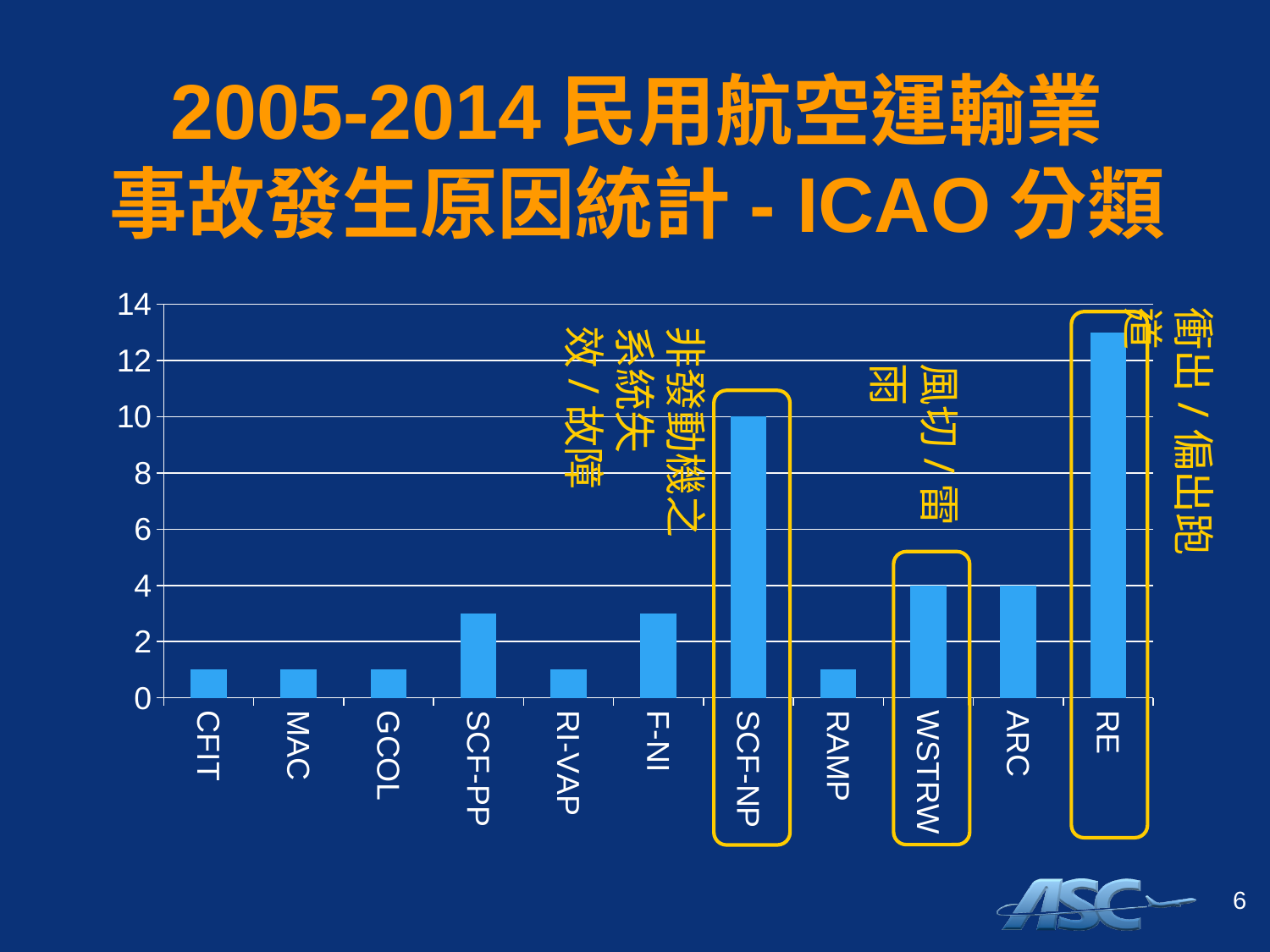
Is the value for SCF-PP greater or less than 4? less What is the value for ARC? 4 How many bars are outlined with yellow boxes in the chart? 3 Is the value for CFIT greater or less than 2? less What is the value for SCF-NP? 10 What is the difference between the value for SCF-NP and the value for WSTRW? 6 Is the value for RE greater or less than 12? greater How many categories are shown on the x axis of the chart? 11 Which is larger, the value for SCF-NP or the value for WSTRW? SCF-NP Which category has the highest value in the chart? RE What kind of chart is shown on the slide? bar chart What is the value for WSTRW? 4